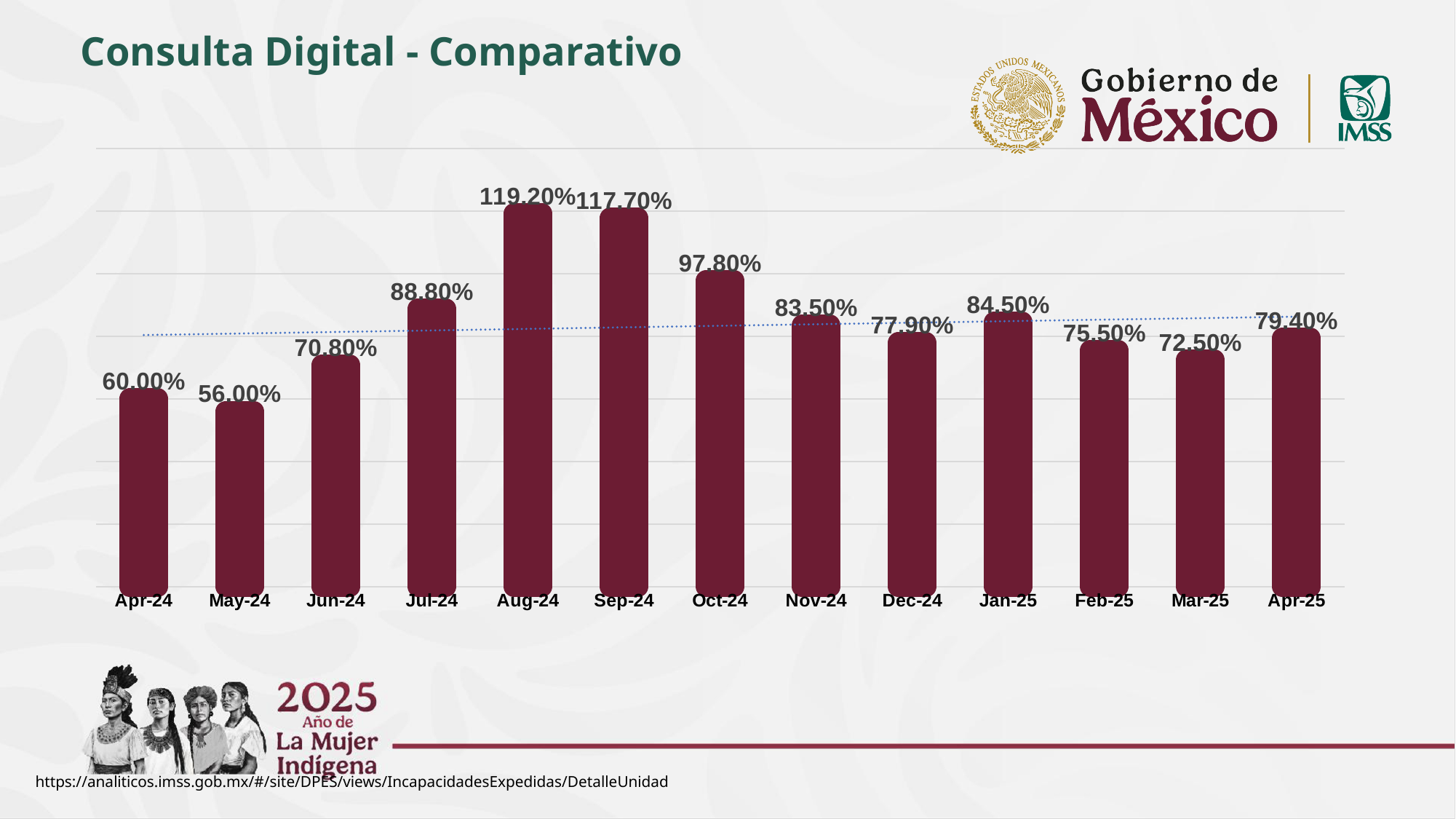
What is the value for Apr-25? 79.40% Which month has the highest value? Aug-24 What is the value for May-24? 56.00% What is the value for Jan-25? 84.50% How many months are shown on the x axis? 13 What kind of chart is shown on the slide? Bar chart Which month has the lowest value? May-24 Which is larger, the value for Nov-24 or the value for Dec-24? Nov-24 What is the difference between the values for Aug-24 and Sep-24? 1.50% What is the value for Aug-24? 119.20% What is the title of the chart on the slide? Consulta Digital - Comparativo What is the difference between the values for Jul-24 and Jun-24? 18.00%